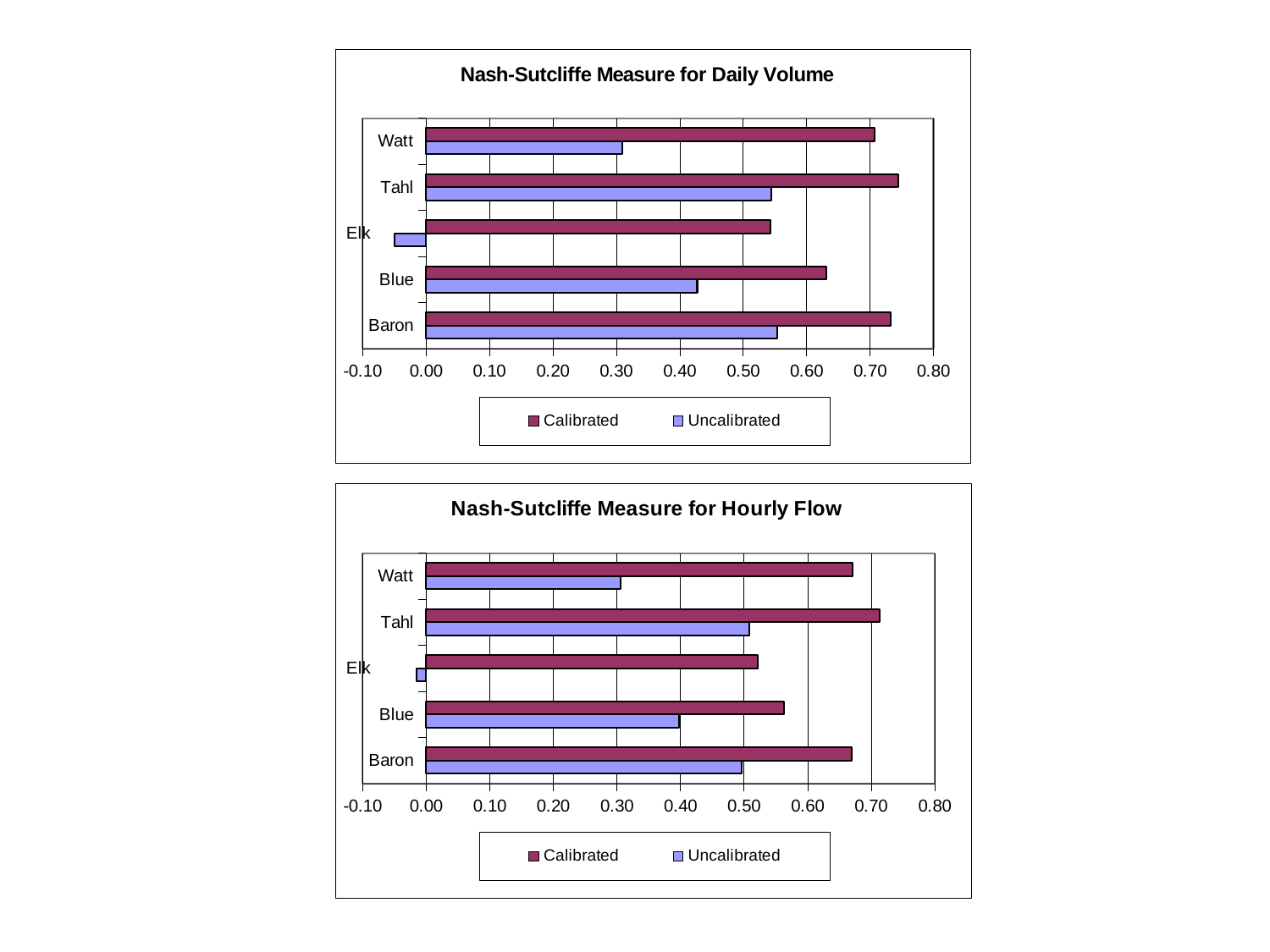
In the Nash-Sutcliffe Measure for Hourly Flow chart, which category has the highest Calibrated value? Tahl In the Nash-Sutcliffe Measure for Daily Volume chart, is the Uncalibrated value for Watt greater or less than 0.40? less In the Nash-Sutcliffe Measure for Daily Volume chart, what kind of chart is shown? bar chart In the Nash-Sutcliffe Measure for Daily Volume chart, how many categories are shown on the vertical axis? 5 In the Nash-Sutcliffe Measure for Hourly Flow chart, what colour are the Uncalibrated bars? light blue In the Nash-Sutcliffe Measure for Daily Volume chart, how many series does the legend list? 2 In the Nash-Sutcliffe Measure for Daily Volume chart, is the Calibrated value for Elk greater or less than 0.50? greater In the Nash-Sutcliffe Measure for Daily Volume chart, which category has the lowest Calibrated value? Elk In the Nash-Sutcliffe Measure for Daily Volume chart, which is larger for Blue, the Calibrated or the Uncalibrated value? Calibrated In the Nash-Sutcliffe Measure for Hourly Flow chart, which category has the lowest Uncalibrated value? Elk In the Nash-Sutcliffe Measure for Daily Volume chart, which category has the lowest Uncalibrated value? Elk In the Nash-Sutcliffe Measure for Hourly Flow chart, is the Uncalibrated value for Blue greater or less than 0.50? less